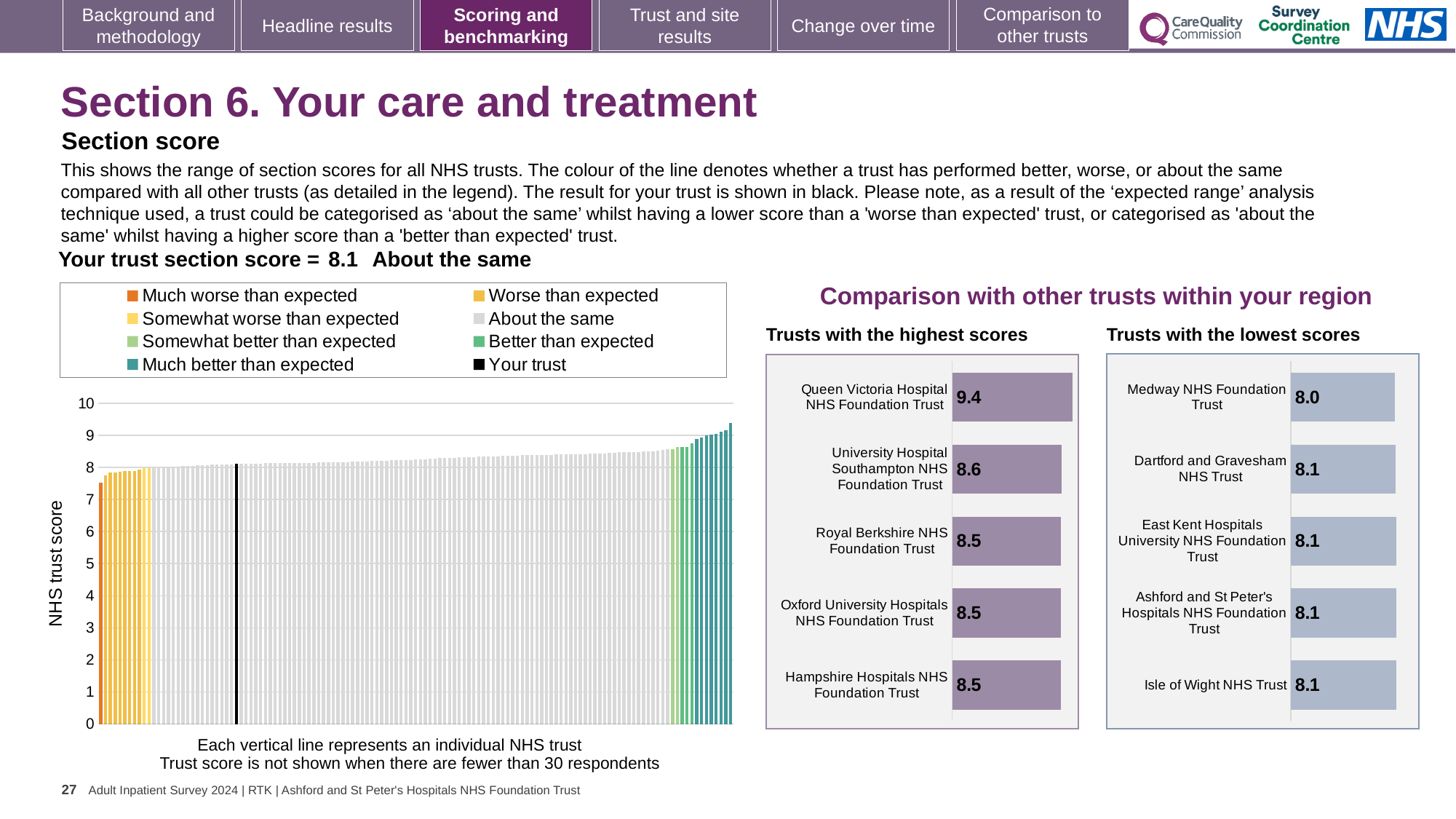
What kind of chart is the main 'NHS trust score' chart on the left of the slide? Bar chart In the 'Trusts with the highest scores' chart, what is the score for University Hospital Southampton NHS Foundation Trust? 8.6 How many trusts are shown in the 'Trusts with the highest scores' chart? 5 In the 'Trusts with the highest scores' chart, what is the score for Queen Victoria Hospital NHS Foundation Trust? 9.4 In the 'Trusts with the lowest scores' chart, what is the score for Isle of Wight NHS Trust? 8.1 Which has the larger score: Queen Victoria Hospital NHS Foundation Trust in the 'Trusts with the highest scores' chart or Medway NHS Foundation Trust in the 'Trusts with the lowest scores' chart? Queen Victoria Hospital NHS Foundation Trust In the 'Trusts with the lowest scores' chart, which trust has the lowest score? Medway NHS Foundation Trust In the 'Trusts with the lowest scores' chart, what is the score for Medway NHS Foundation Trust? 8.0 In the main 'NHS trust score' chart on the left, do the values rise or fall from left to right along the x axis? Rise How many entries does the legend of the main 'NHS trust score' chart on the left list? 8 In the 'Trusts with the highest scores' chart, what is the difference between the scores of Queen Victoria Hospital NHS Foundation Trust and University Hospital Southampton NHS Foundation Trust? 0.8 In the 'Trusts with the highest scores' chart, which trust has the highest score? Queen Victoria Hospital NHS Foundation Trust